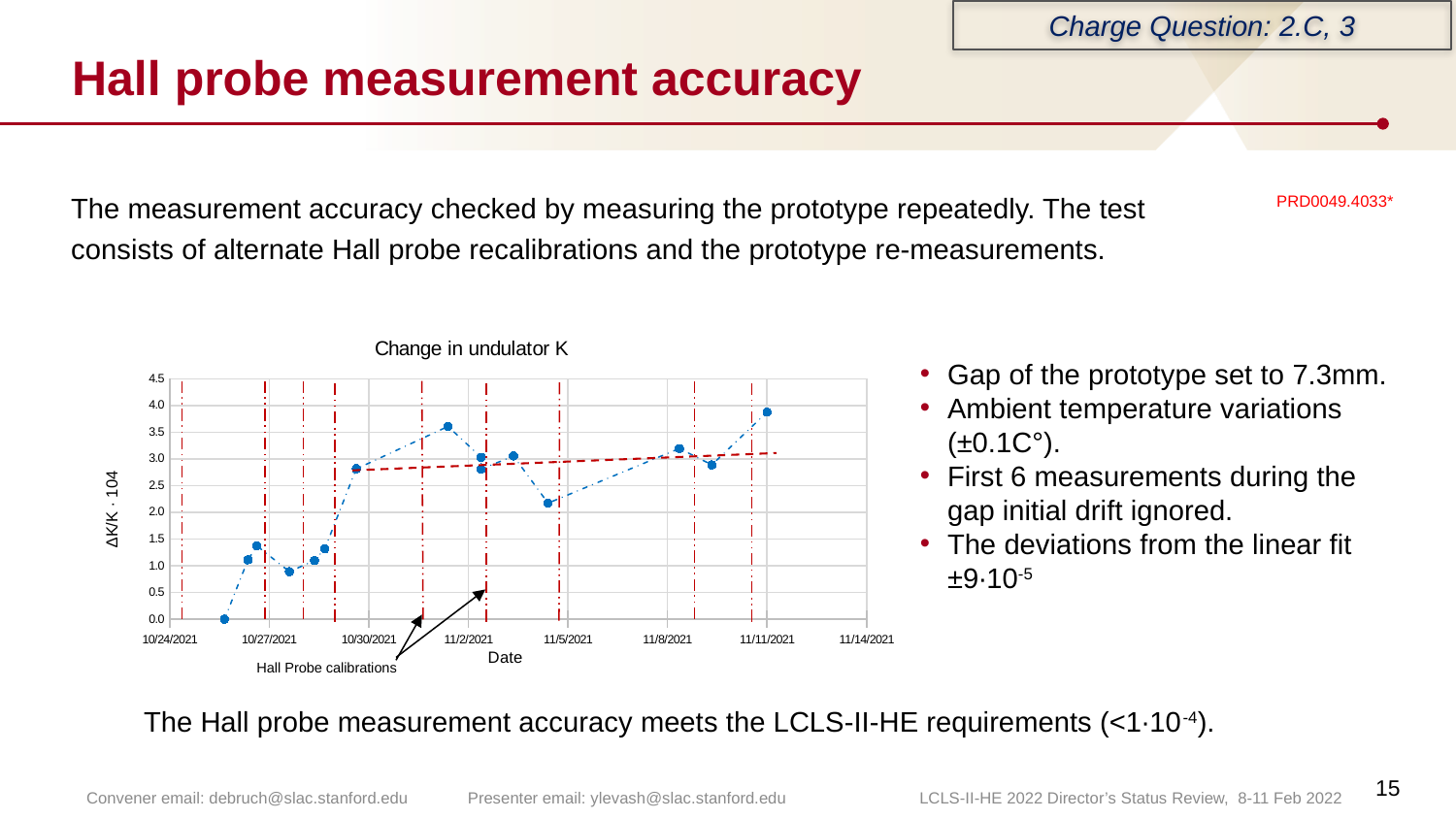
Is the value of the data point just after 10/30/2021 greater or less than 3.5? greater Which is larger: the data point just after 10/30/2021 or the data point just before 11/5/2021? the point just after 10/30/2021 Is the value of the data point just before 11/5/2021 greater or less than 2.5? less Do the plotted values overall rise or fall from left to right along the date axis? rise What kind of chart is shown on the slide? line chart What is the value of the first data point in the series (around 10/25/2021)? 0.0 What is the last date tick shown on the x axis? 11/14/2021 What is the highest tick value shown on the y axis? 4.5 What is the title of the chart? Change in undulator K Is the highest data point located at the beginning or at the end of the series? at the end Is the value of the last data point (around 11/11/2021) greater or less than 3.5? greater